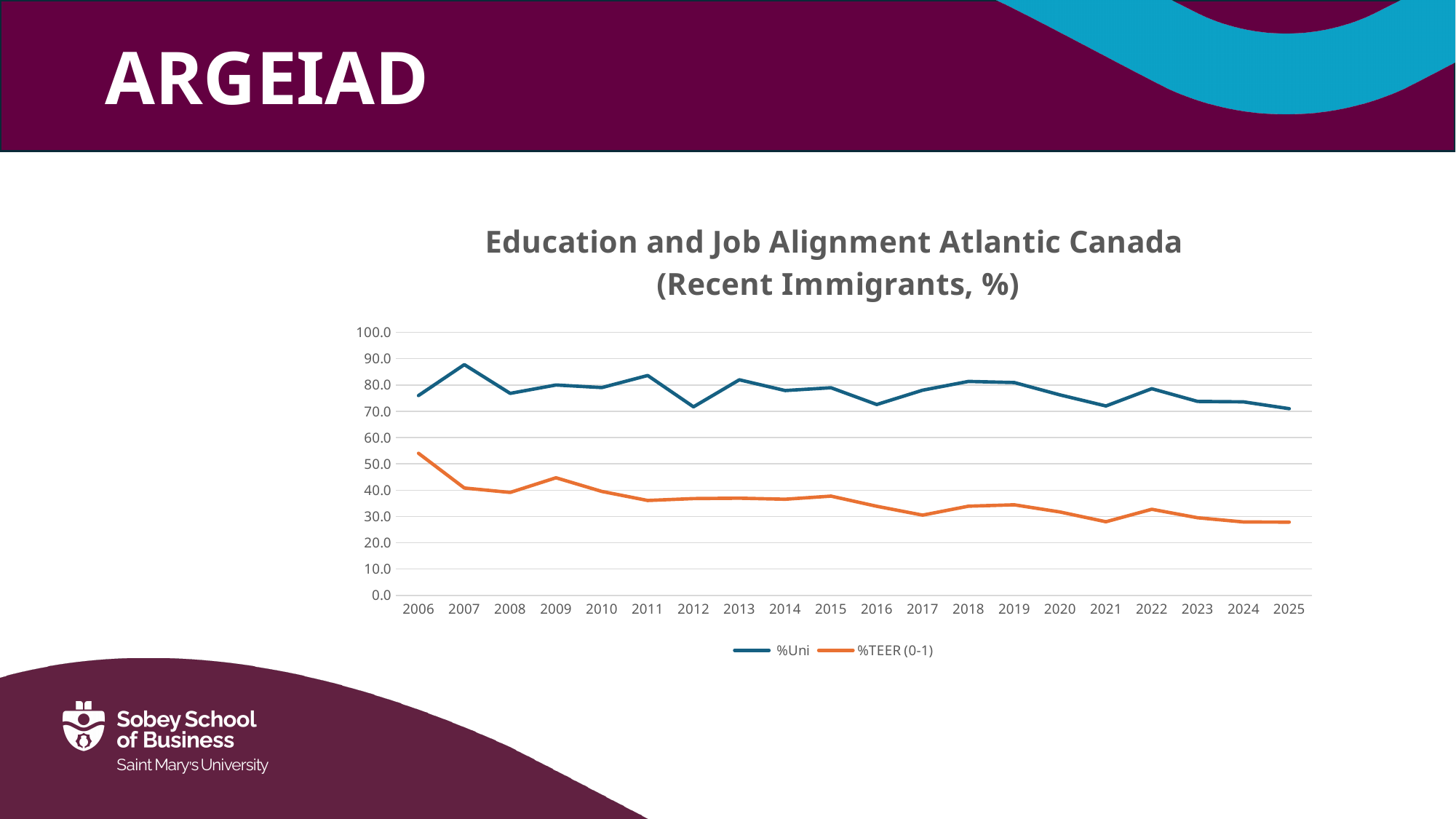
Is the value for %TEER (0-1) in 2006 greater or less than 50.0? greater How many years are plotted along the x axis? 20 In which year is the %Uni series at its highest? 2007 How many series does the legend list? 2 What kind of chart is shown on the slide? line chart Which series is drawn in orange? %TEER (0-1) Is the value for %TEER (0-1) in 2025 greater or less than 30.0? less Does the %TEER (0-1) series generally rise or fall from 2006 to 2025? fall Is the value for %Uni in 2007 greater or less than 80.0? greater What is the title of the chart? Education and Job Alignment Atlantic Canada (Recent Immigrants, %) In which year is the %TEER (0-1) series at its highest? 2006 In 2015, which series has the larger value, %Uni or %TEER (0-1)? %Uni